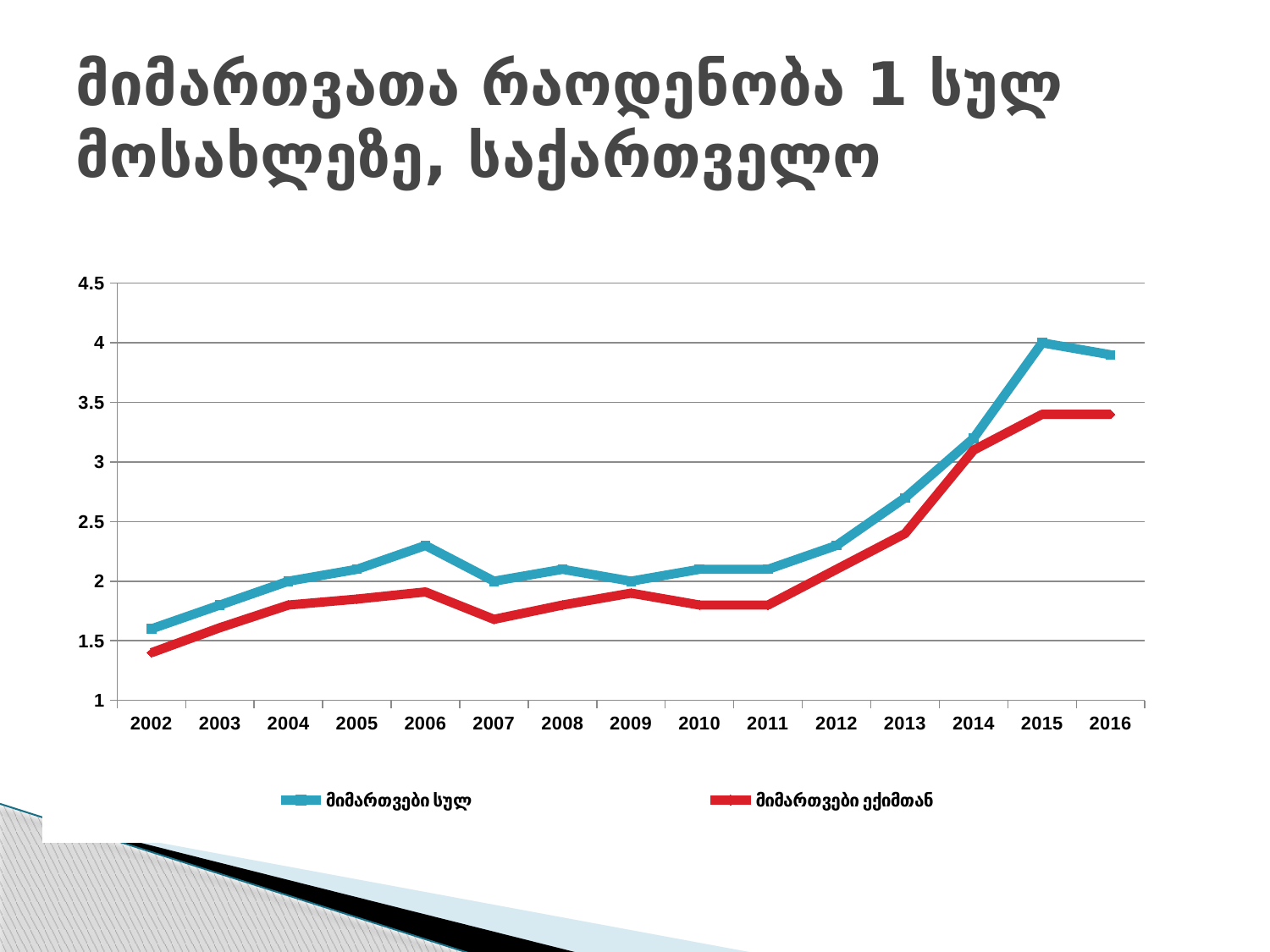
Is the value for მიმართვები ექიმთან in 2002 greater or less than 1.5? less In which year does the მიმართვები სულ series reach its highest value? 2015 How many years are shown on the x axis? 15 Is the value for მიმართვები ექიმთან in 2016 greater or less than 3.5? less What is the value of მიმართვები სულ in 2015? 4 What kind of chart is shown on the slide? line chart Which series has the larger value in 2015, მიმართვები სულ or მიმართვები ექიმთან? მიმართვები სულ What is the value of მიმართვები სულ in 2004? 2 In which year is the მიმართვები ექიმთან series at its lowest? 2002 Is the value for მიმართვები სულ in 2002 greater or less than 2? less How many series does the legend list? 2 Overall, do the values of მიმართვები სულ rise or fall from 2002 to 2016? rise